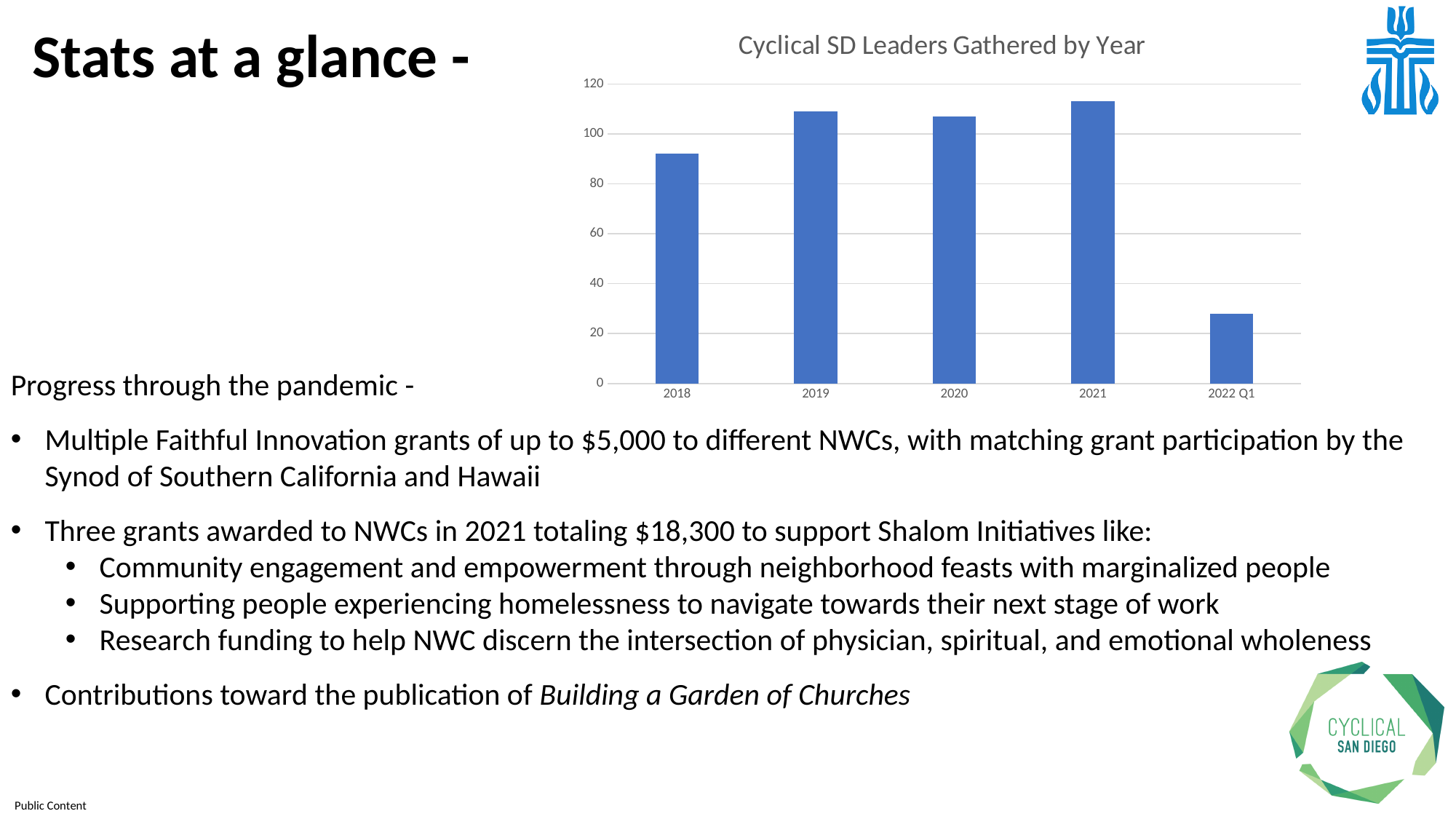
Is the value for 2022 Q1 greater or less than 40? less What is the title of the chart? Cyclical SD Leaders Gathered by Year What kind of chart is shown on the slide? Bar chart Is the value for 2018 greater or less than 80? greater Which year has the lowest number of leaders gathered? 2022 Q1 What colour are the bars in the chart? Blue Is the value for 2022 Q1 greater or less than 20? greater Which is larger, the value for 2018 or the value for 2019? 2019 How many categories are shown on the x axis of the chart? 5